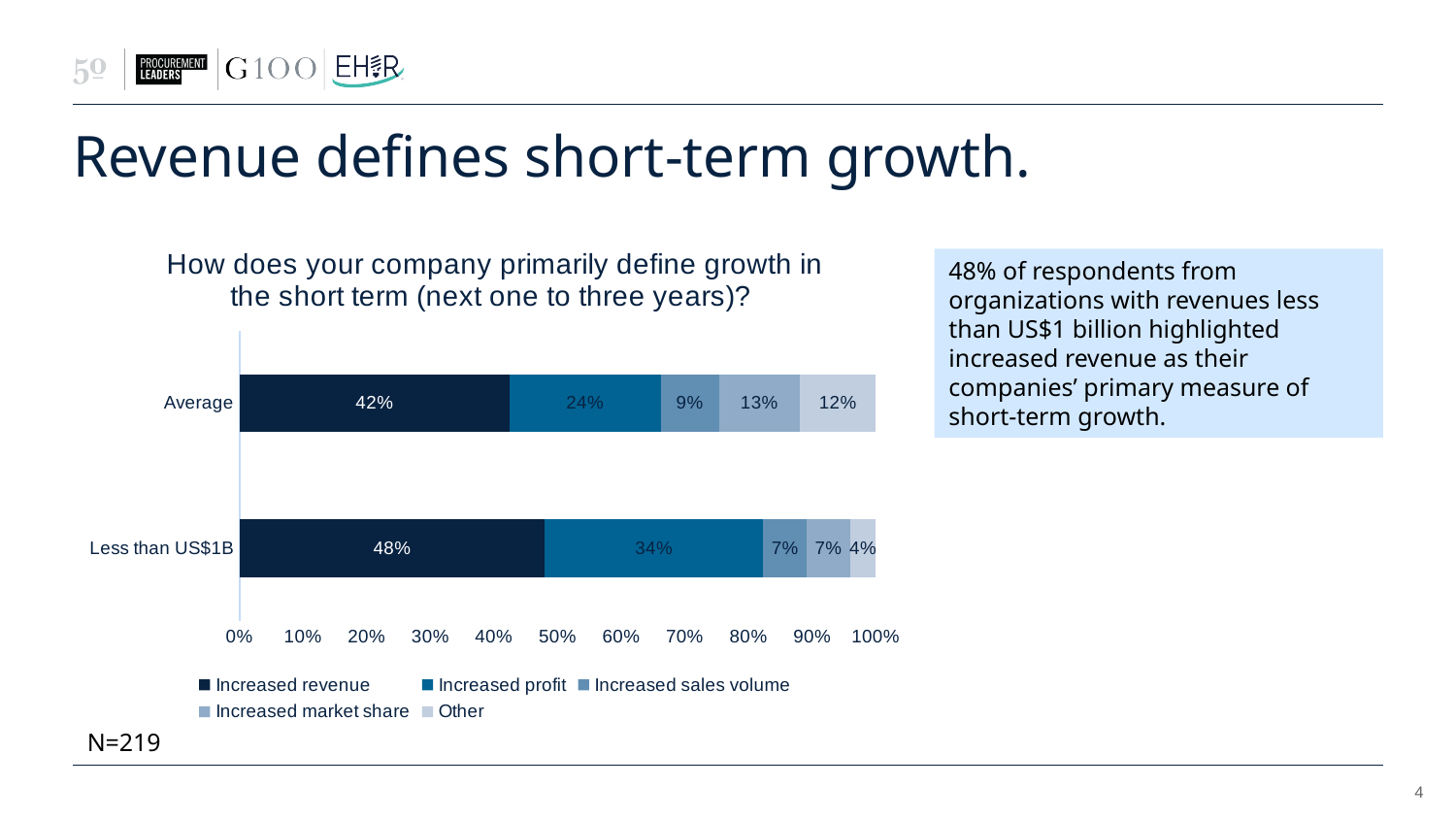
Which series has the lowest value in the Average bar? Increased sales volume What kind of chart is shown on the slide? Stacked bar chart What is the difference between the Increased revenue values for Less than US$1B and Average? 6% Which series has the highest value in the Less than US$1B bar? Increased revenue Which category has the larger Increased profit value, Average or Less than US$1B? Less than US$1B What percentage of respondents in the Average category chose Increased revenue? 42% How many categories are shown on the y axis of the chart? 2 What is the title of the chart? How does your company primarily define growth in the short term (next one to three years)? What is the Increased market share value for the Less than US$1B category? 7% What is the Increased profit value for the Less than US$1B category? 34% What is the Other value for the Average category? 12% How many series does the legend list? 5